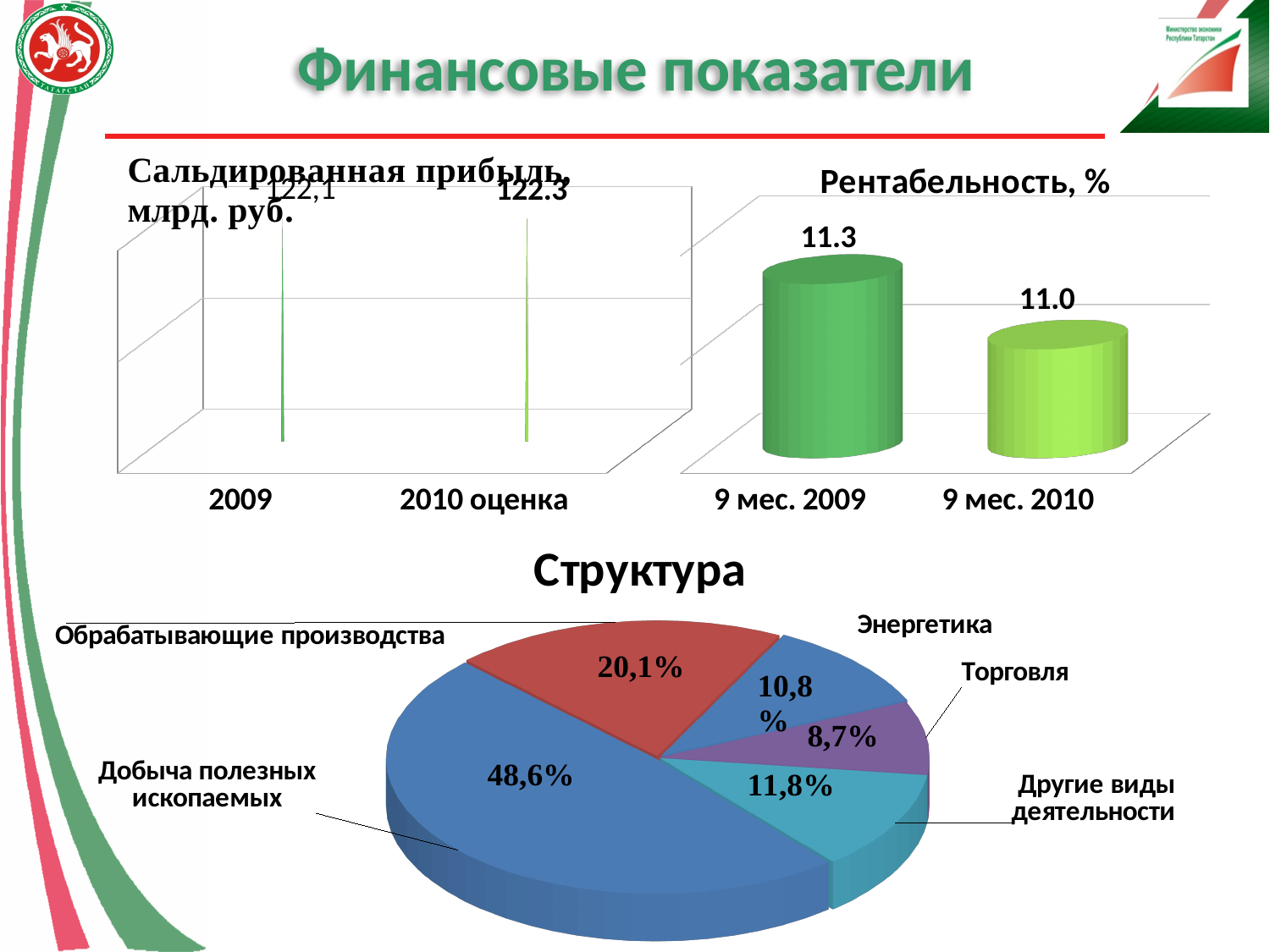
How many categories are shown in the 'Сальдированная прибыль, млрд. руб.' chart? 2 In the 'Рентабельность, %' chart, what is the value for 9 мес. 2010? 11.0 In the 'Рентабельность, %' chart, which period has the higher value? 9 мес. 2009 In the 'Структура' pie chart, which is larger: Энергетика or Другие виды деятельности? Другие виды деятельности In the 'Структура' pie chart, which slice is the smallest? Торговля What kind of chart is the 'Структура' chart? Pie chart In the 'Сальдированная прибыль, млрд. руб.' chart, what is the value for 2009? 122,1 In the 'Рентабельность, %' chart, what is the difference between the 9 мес. 2009 and 9 мес. 2010 values? 0.3 In the 'Сальдированная прибыль, млрд. руб.' chart, what is the value for 2010 оценка? 122.3 In the 'Структура' pie chart, what share does Торговля have? 8,7% In the 'Рентабельность, %' chart, what is the value for 9 мес. 2009? 11.3 In the 'Структура' pie chart, what share does Добыча полезных ископаемых have? 48,6%